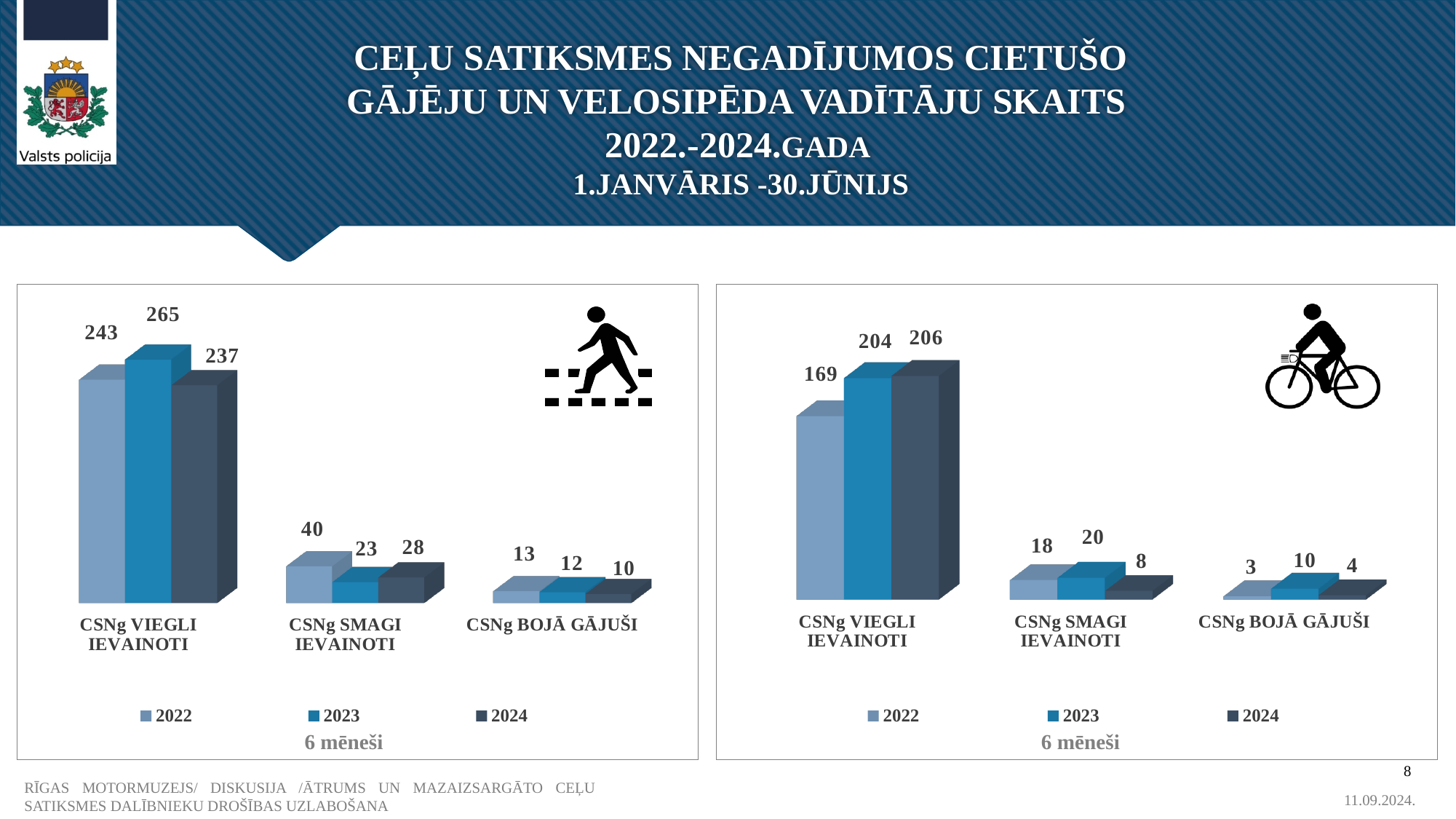
How many categories are shown on the x axis of the left chart? 3 In the right chart, which year has the lowest value in the CSNg BOJĀ GĀJUŠI category? 2022 In the right chart, what is the difference between the 2023 and 2022 values in the CSNg VIEGLI IEVAINOTI category? 35 In the right chart, what is the value for 2023 in the CSNg SMAGI IEVAINOTI category? 20 What type of chart is the left chart? Bar chart In the left chart, what is the value for 2023 in the CSNg VIEGLI IEVAINOTI category? 265 In the right chart, which is larger in the CSNg SMAGI IEVAINOTI category: the 2022 value or the 2024 value? 2022 In the left chart, what is the value for 2024 in the CSNg BOJĀ GĀJUŠI category? 10 In the left chart, which year has the highest value in the CSNg SMAGI IEVAINOTI category? 2022 In the left chart, what is the difference between the 2023 and 2024 values in the CSNg VIEGLI IEVAINOTI category? 28 How many series does the legend of the right chart list? 3 In the right chart, what is the value for 2022 in the CSNg VIEGLI IEVAINOTI category? 169